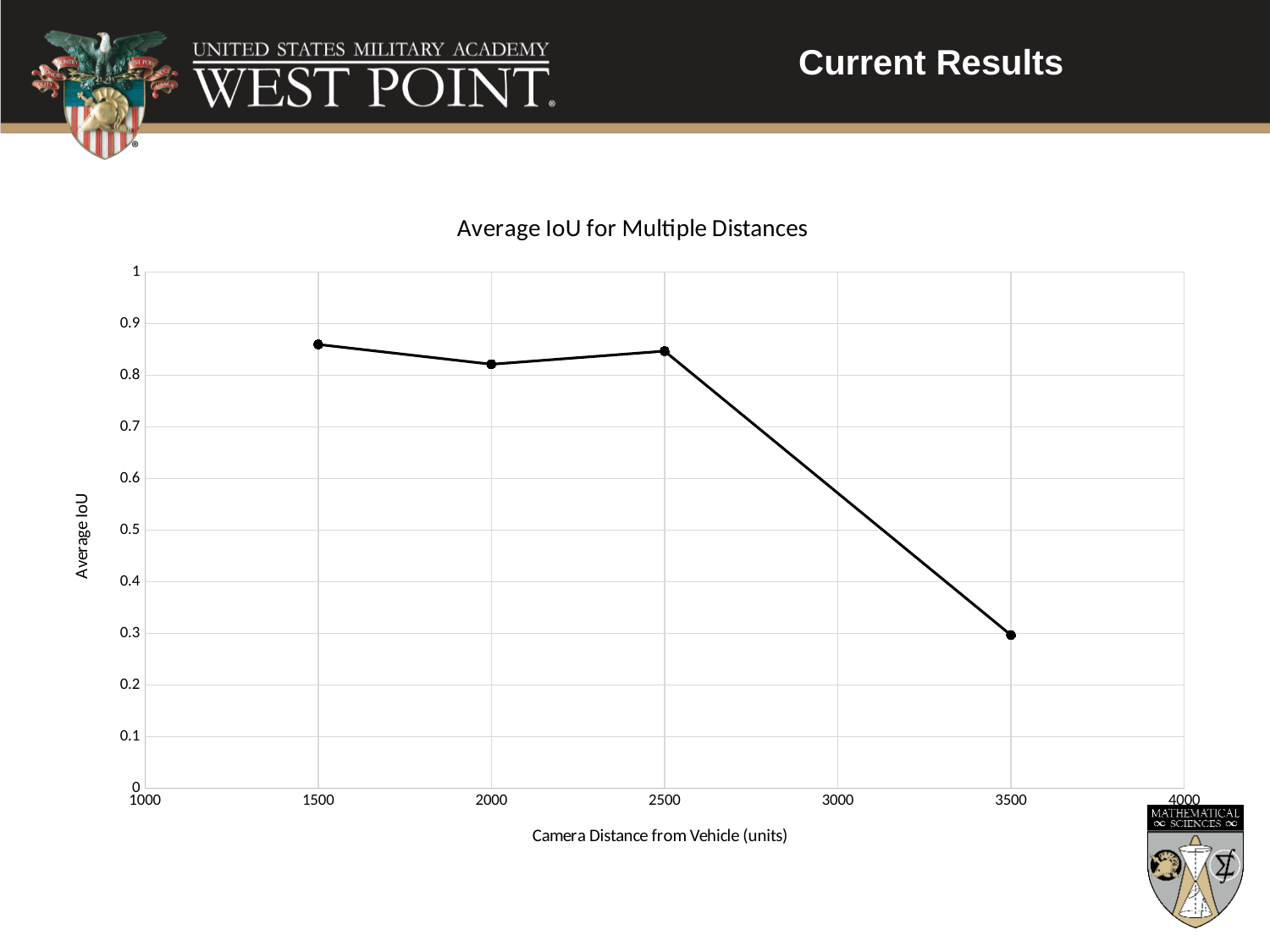
Is the average IoU at a camera distance of 3500 greater or less than 0.4? less Which has a higher average IoU: camera distance 1500 or camera distance 2000? 1500 At which camera distance is the average IoU lowest? 3500 What is the title of the chart? Average IoU for Multiple Distances Overall, does the average IoU rise or fall as camera distance increases from 1500 to 3500? fall How many data points are plotted on the line? 4 Is the average IoU at a camera distance of 1500 greater or less than 0.8? greater Is the average IoU at a camera distance of 2000 greater or less than 0.7? greater Which has a higher average IoU: camera distance 2500 or camera distance 3500? 2500 What is the label of the x axis? Camera Distance from Vehicle (units) What kind of chart is shown on the slide? line chart